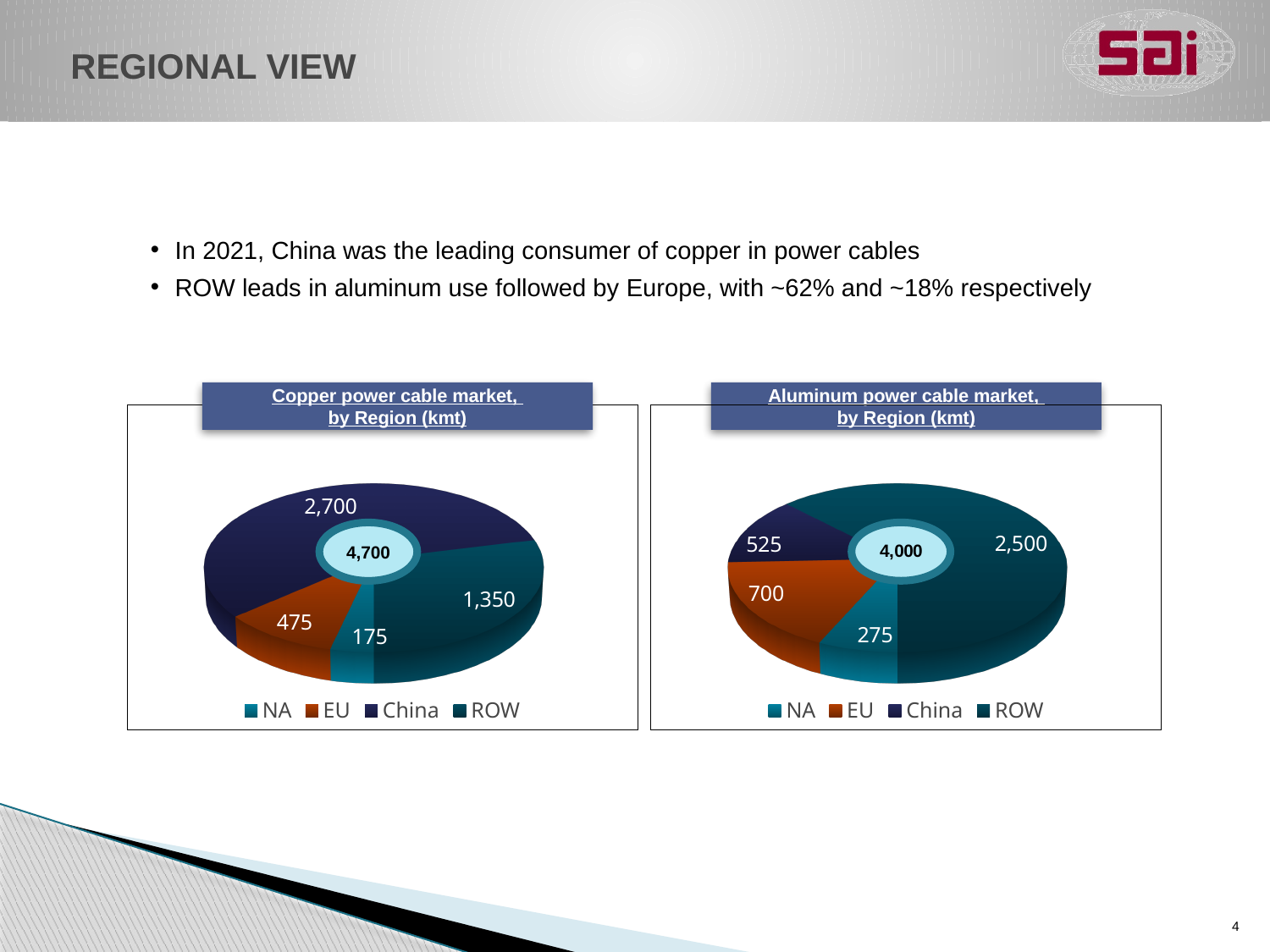
In the Aluminum power cable market chart, which is larger, the value for China or the value for EU? EU In the Copper power cable market chart, what is the value for China? 2,700 In the Copper power cable market chart, what is the difference between the ROW and EU values? 875 In the Copper power cable market chart, what is the value for NA? 175 In the Aluminum power cable market chart, what share of the total does ROW represent? 62.5% In the Aluminum power cable market chart, which region has the smallest slice? NA In the Aluminum power cable market chart, what is the value for ROW? 2,500 How many series does the legend of the Copper power cable market chart list? 4 In the Aluminum power cable market chart, what is the value for EU? 700 In the Copper power cable market chart, which region has the largest slice? China What type of chart is the Copper power cable market chart? Pie chart What is the total shown in the centre of the Aluminum power cable market chart? 4,000